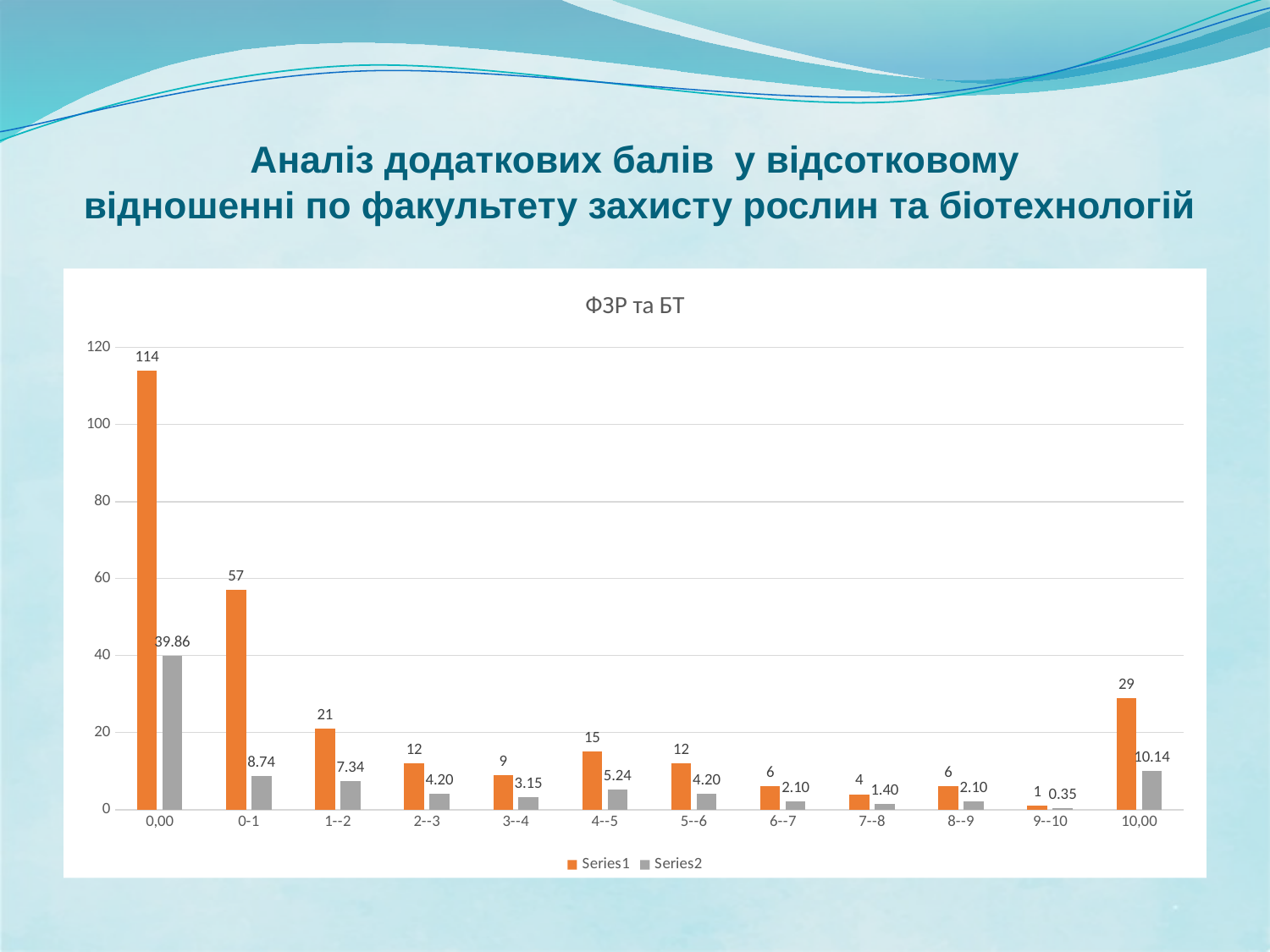
Is the Series2 value for 0,00 greater or less than 20? greater What is the Series1 value for the category 10,00? 29 How many series does the legend list? 2 What is the Series1 value for the category 0,00? 114 Which is larger: the Series1 value for 4--5 or the Series1 value for 5--6? 4--5 What kind of chart is shown on the slide? bar chart How many categories are shown on the x axis? 12 What is the Series2 value for the category 0-1? 8.74 What is the Series2 value for the category 9--10? 0.35 Which category has the highest Series1 value? 0,00 Which category has the lowest Series2 value? 9--10 What is the difference between the Series1 values for 0,00 and 0-1? 57